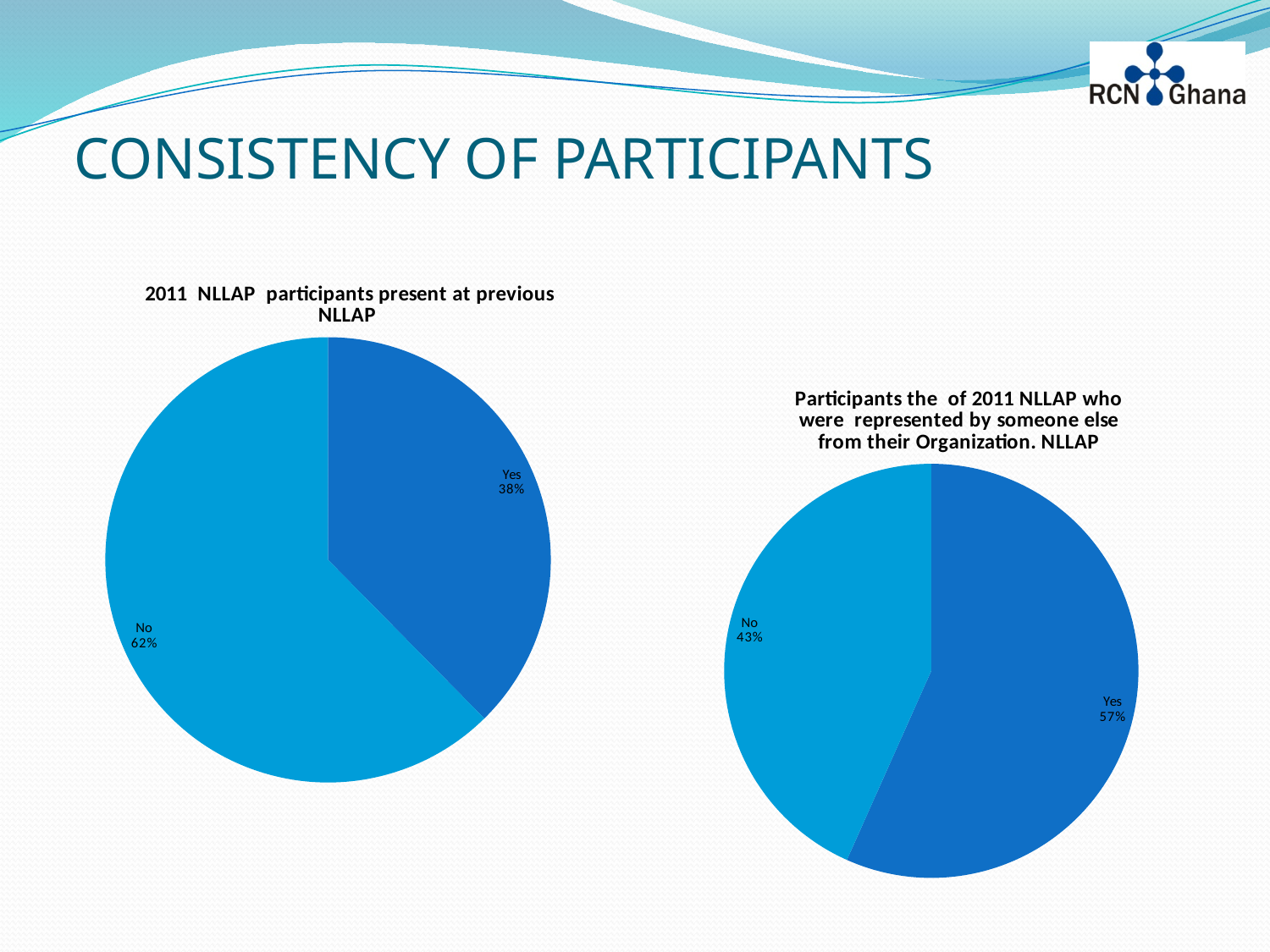
How many slices does the left pie chart have? 2 In the left pie chart, '2011 NLLAP participants present at previous NLLAP', what share is labelled 'Yes'? 38% In the left pie chart, what is the difference in percentage points between the 'No' and 'Yes' slices? 24 Is the 'Yes' share in the left pie chart larger or smaller than the 'Yes' share in the right pie chart? smaller In the right pie chart, what is the difference in percentage points between the 'Yes' and 'No' slices? 14 What type of chart is used on the right side of the slide? pie chart In the left pie chart, '2011 NLLAP participants present at previous NLLAP', what share is labelled 'No'? 62% In the left pie chart, which slice is larger, 'Yes' or 'No'? No In the right pie chart about participants represented by someone else from their organization, what share is labelled 'No'? 43% In the right pie chart, which slice is smaller, 'Yes' or 'No'? No What is the title of the left chart? 2011 NLLAP participants present at previous NLLAP